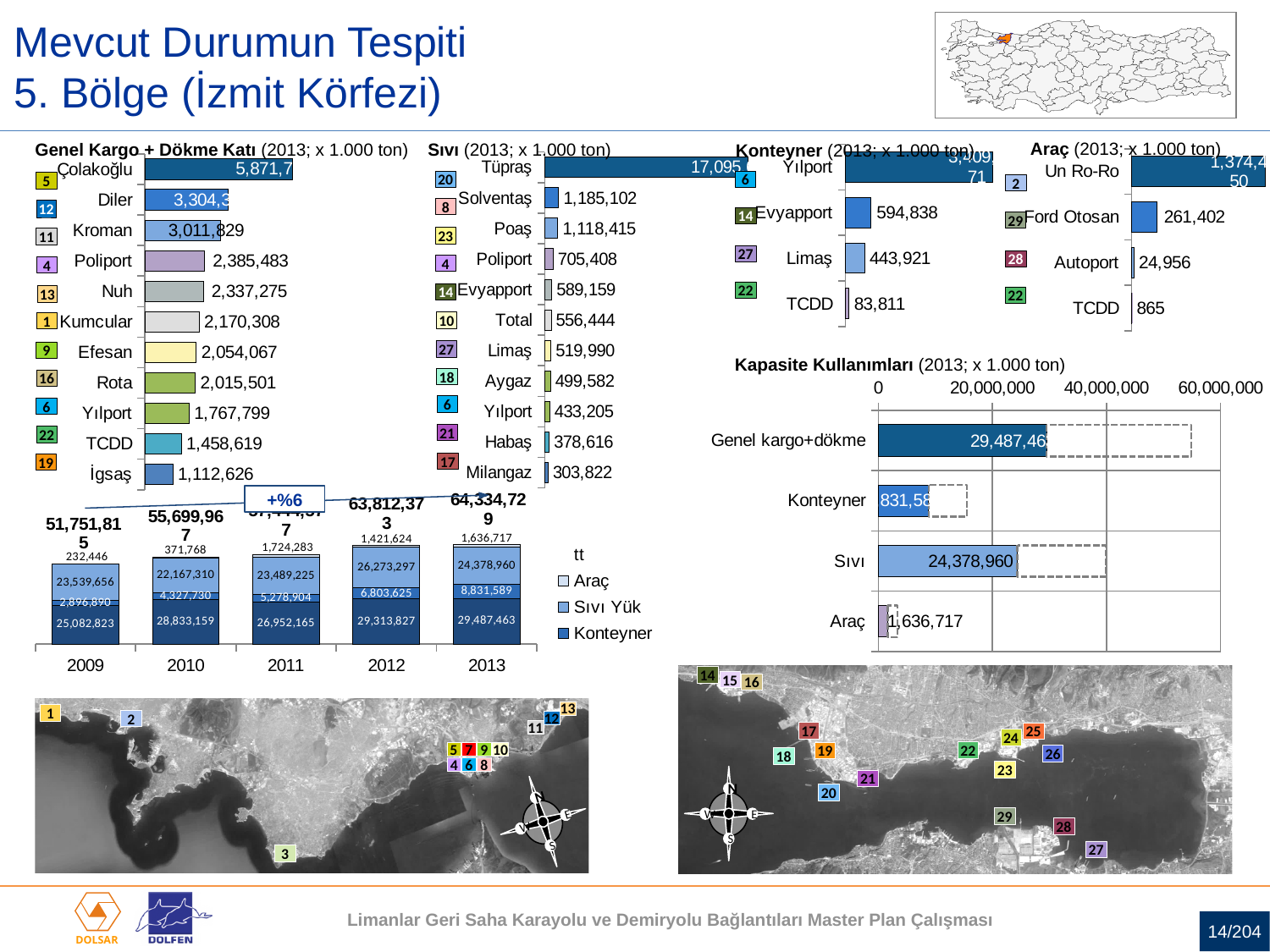
In the Konteyner chart, what is the value for Evyapport? 594,838 In the Genel Kargo + Dökme Katı chart, what is the difference between Poliport and Nuh? 48,208 In the Sıvı chart, what is the value for Solventaş? 1,185,102 In the Sıvı chart, which category has the highest value? Tüpraş In the Genel Kargo + Dökme Katı chart, which category has the lowest value? İgsaş In the Araç chart, what is the value for Ford Otosan? 261,402 In the Araç chart, how many categories are shown? 4 In the Genel Kargo + Dökme Katı chart, what is the value for Kroman? 3,011,829 In the stacked bar chart of years 2009 to 2013, what is the total for 2012? 63,812,373 In the Sıvı chart, which is larger, Aygaz or Habaş? Aygaz In the Kapasite Kullanımları chart, is the value for Sıvı greater or less than 20,000,000? greater In the Genel Kargo + Dökme Katı chart, how many categories are shown? 11